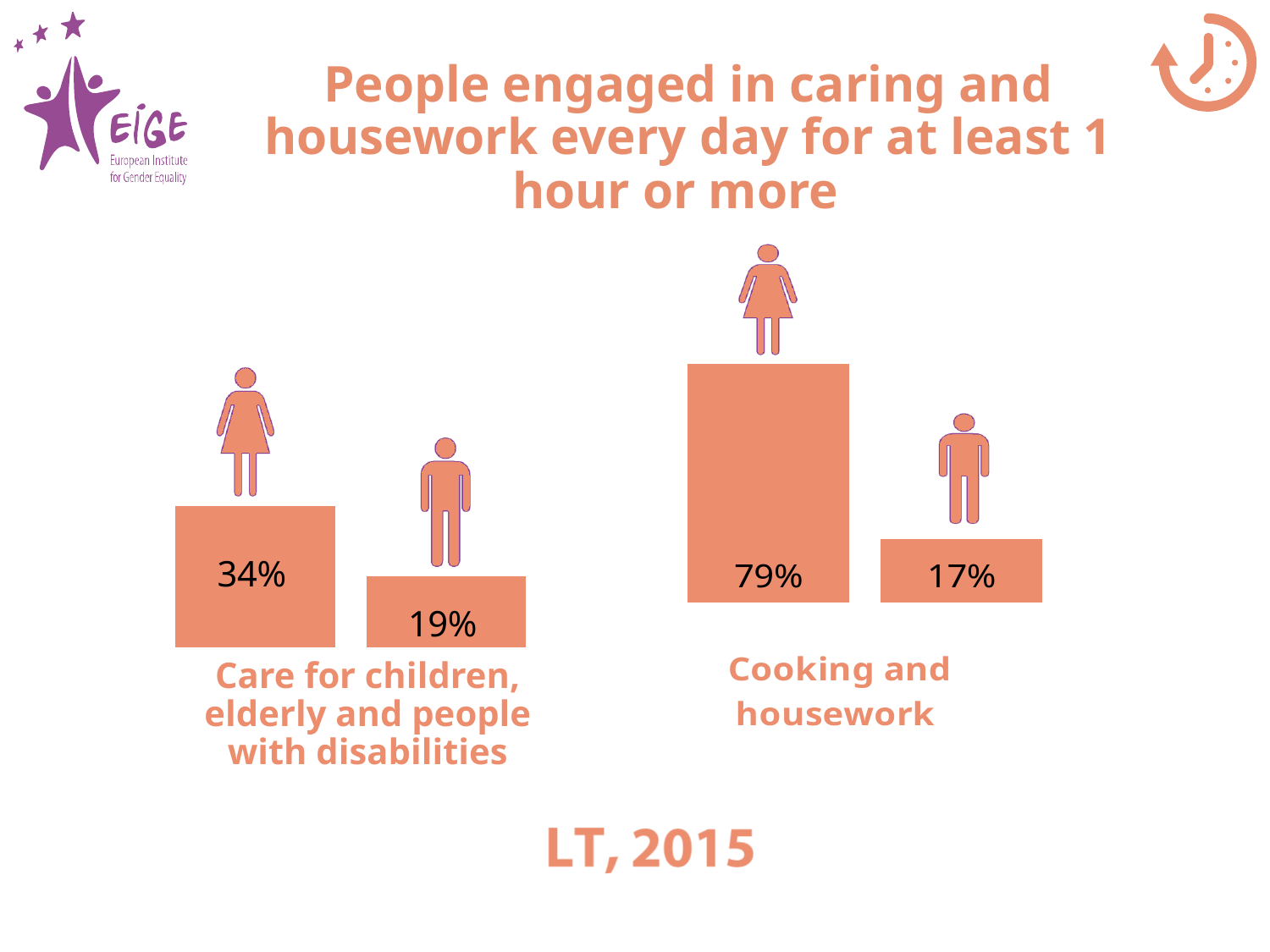
How many activity categories are shown on the slide? 2 What is the difference between the women's and men's values for care for children, elderly and people with disabilities? 15 percentage points Is the value for women higher for cooking and housework or for care for children, elderly and people with disabilities? Cooking and housework What kind of chart is shown on the slide? Bar chart What percentage of men are engaged in care for children, elderly and people with disabilities every day for at least 1 hour? 19% What percentage of men are engaged in cooking and housework every day for at least 1 hour? 17% Which bar shows the highest value on the slide? Women, cooking and housework (79%) What is the difference between the women's and men's values for cooking and housework? 62 percentage points What percentage of women are engaged in care for children, elderly and people with disabilities every day for at least 1 hour? 34% Which country and year does the chart refer to? LT, 2015 Which bar shows the lowest value on the slide? Men, cooking and housework (17%) What percentage of women are engaged in cooking and housework every day for at least 1 hour? 79%